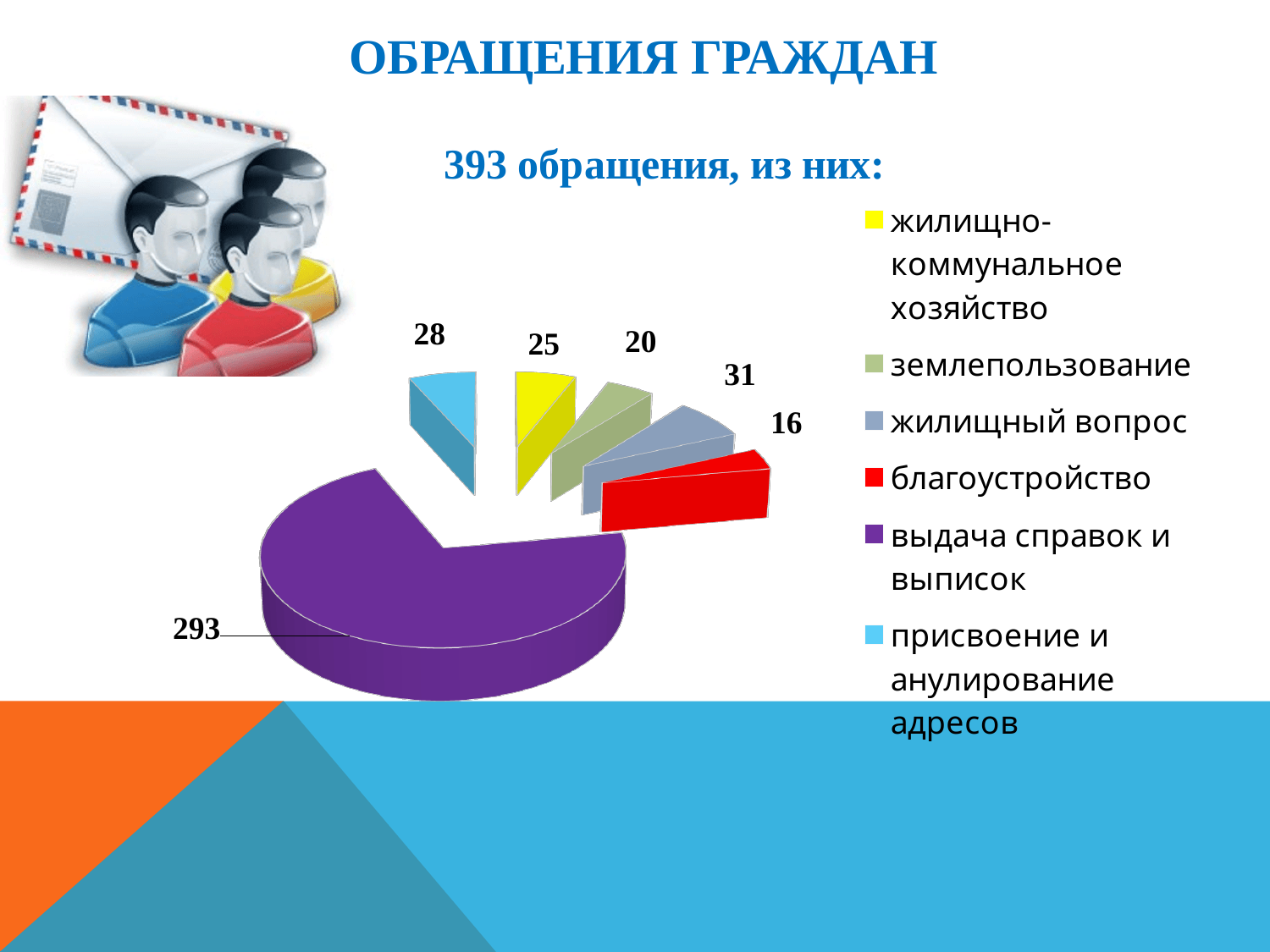
What is the smallest value labelled on the pie chart? 16 What is the value for 'присвоение и анулирование адресов'? 28 What is the difference between the values for 'выдача справок и выписок' and 'присвоение и анулирование адресов'? 265 What is the value for 'жилищно-коммунальное хозяйство'? 25 What is the value for 'землепользование'? 20 What kind of chart is shown on the slide? pie chart How many categories does the pie chart have? 6 What is the value for 'выдача справок и выписок'? 293 How many entries does the legend list? 6 Which is larger: the value for 'жилищно-коммунальное хозяйство' or for 'землепользование'? жилищно-коммунальное хозяйство What colour is the slice for 'выдача справок и выписок'? purple Which category has the largest slice of the pie? выдача справок и выписок